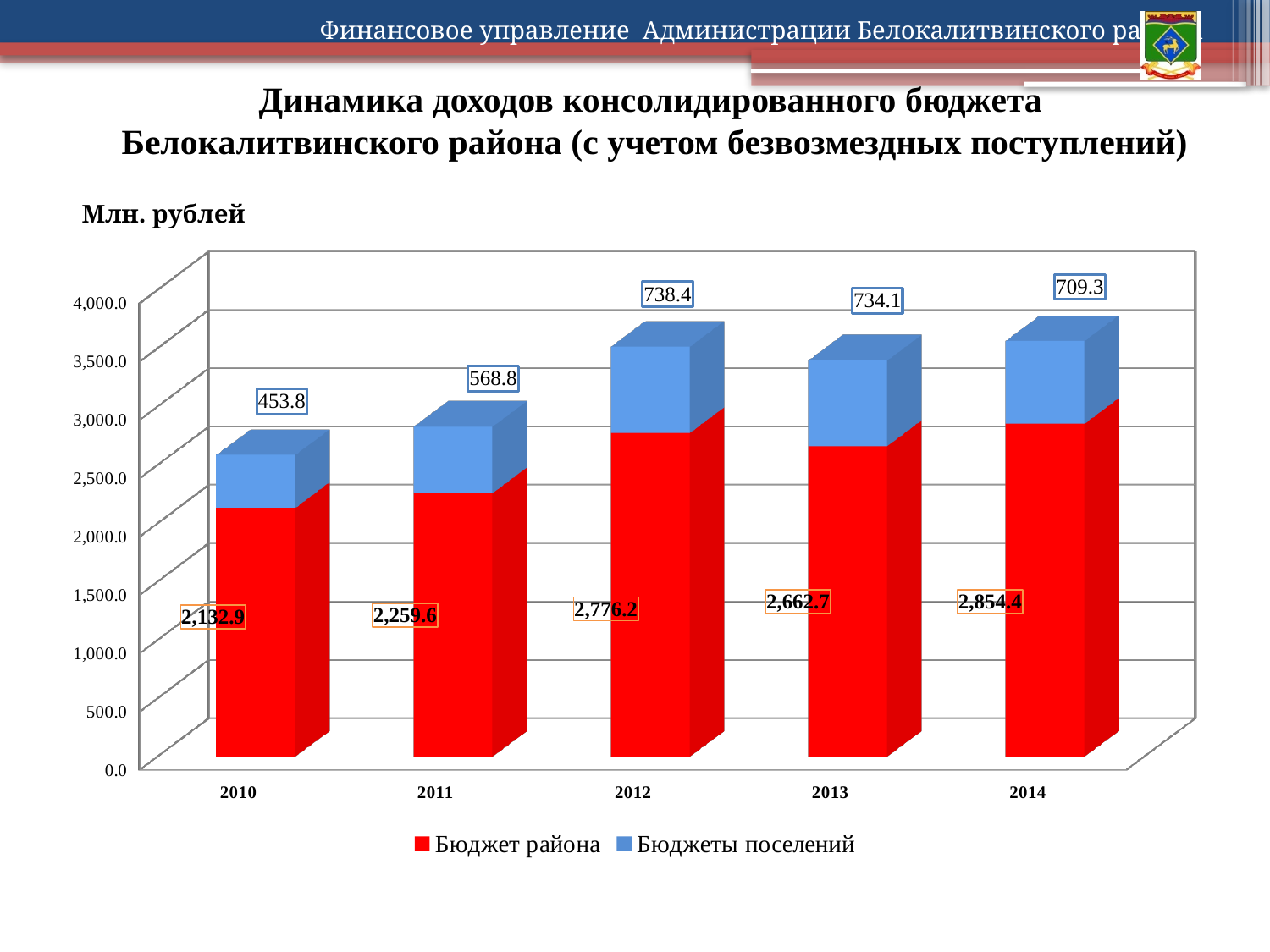
What is the total of the stacked bar for 2012? 3,514.6 In which year is Бюджет района the highest? 2014 What is the difference between Бюджет района in 2014 and in 2010? 721.5 How many series does the legend list? 2 In which year is Бюджеты поселений the lowest? 2010 What type of chart is shown on the slide? stacked bar chart What is the value of Бюджеты поселений for 2010? 453.8 What is the value of Бюджеты поселений for 2014? 709.3 Which is larger: Бюджеты поселений in 2012 or in 2013? 2012 How many years are shown on the x axis? 5 Which series is shown in red in the legend? Бюджет района What is the value of Бюджет района for 2012? 2,776.2